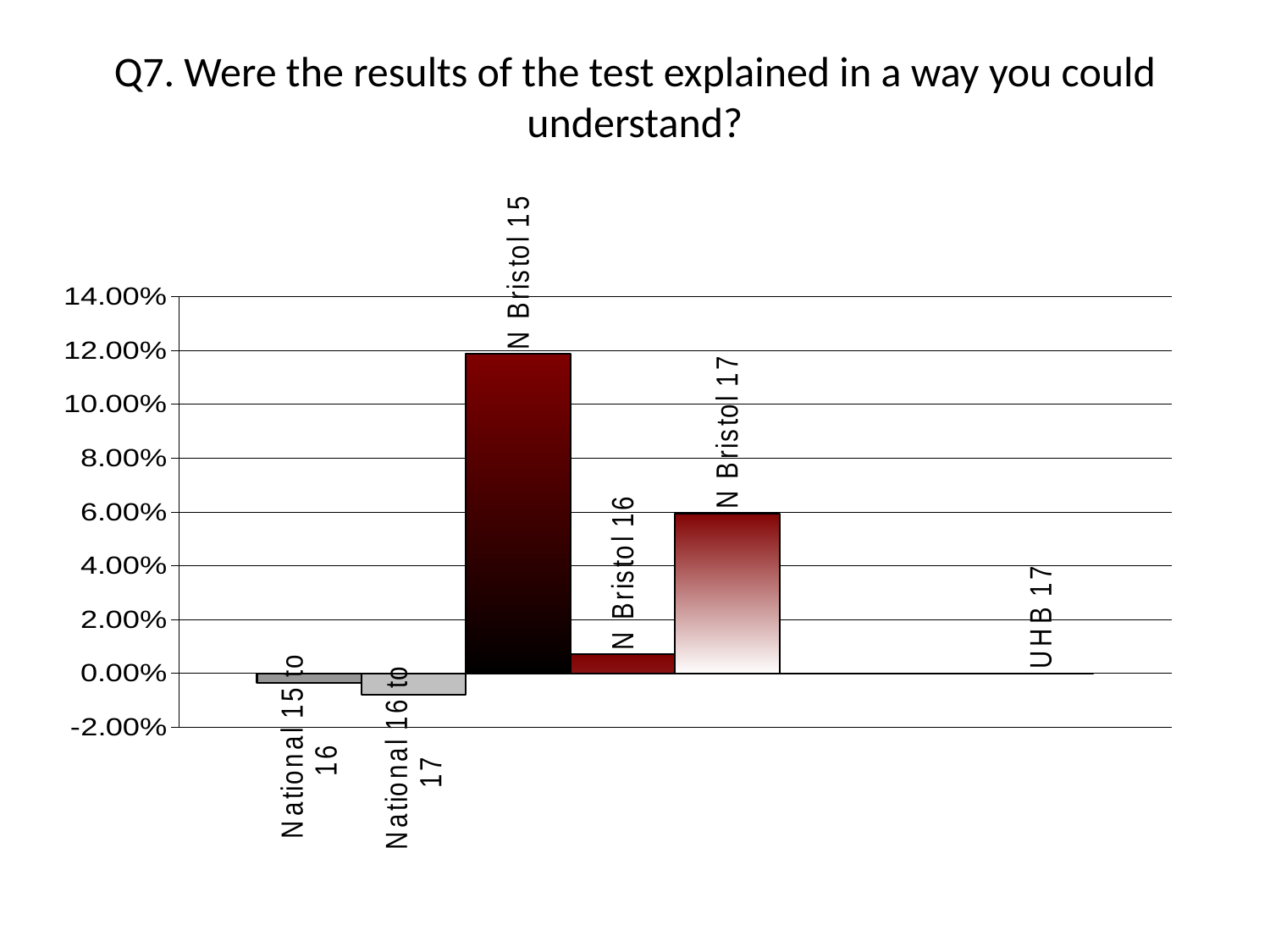
Which category has the lowest value in the chart? National 16 to 17 What kind of chart is shown on the slide? bar chart Is the value for N Bristol 16 greater or less than 2.00%? less What is the title of the chart on the slide? Q7. Were the results of the test explained in a way you could understand? Is the value for National 16 to 17 greater or less than 0.00%? less Which is larger, the value for N Bristol 15 or the value for N Bristol 17? N Bristol 15 Is the value for N Bristol 15 greater or less than 10.00%? greater Which category has the highest value in the chart? N Bristol 15 How many categories are plotted in the chart? 6 Which is larger, the value for N Bristol 17 or the value for N Bristol 16? N Bristol 17